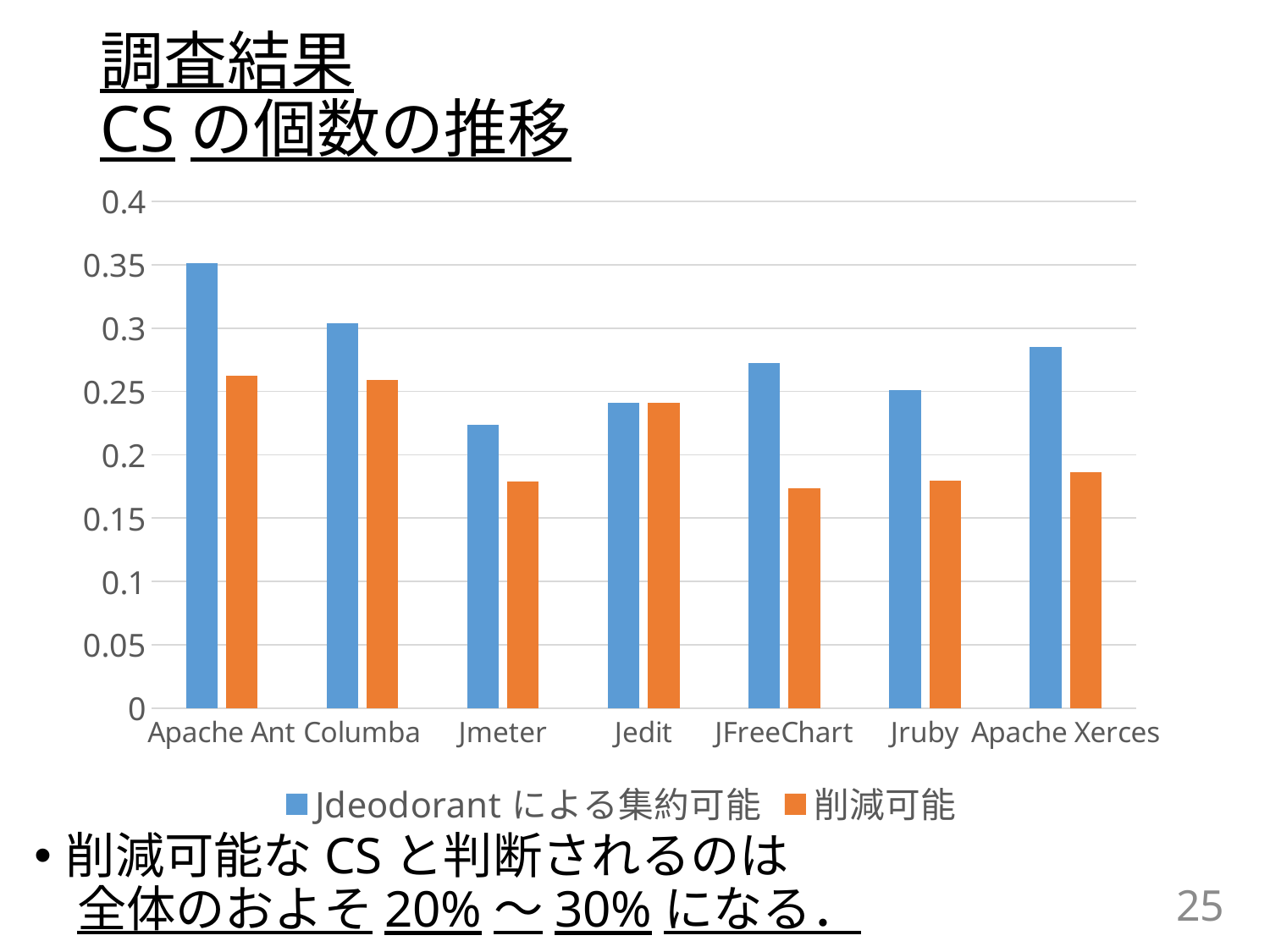
Which project has the highest value for the Jdeodorant による集約可能 series? Apache Ant How many projects (categories) are shown on the x axis? 7 Which is larger for JFreeChart: the Jdeodorant による集約可能 value or the 削減可能 value? Jdeodorant による集約可能 What is the first entry in the chart's legend? Jdeodorant による集約可能 What colour are the bars for the 削減可能 series? orange Is the Jdeodorant による集約可能 value for Apache Xerces greater or less than 0.25? greater Is the Jdeodorant による集約可能 value for Apache Ant greater or less than 0.3? greater What kind of chart is shown on the slide? bar chart How many series does the legend list? 2 Which project has the larger Jdeodorant による集約可能 value: Apache Ant or Columba? Apache Ant Is the 削減可能 value for JFreeChart greater or less than 0.2? less